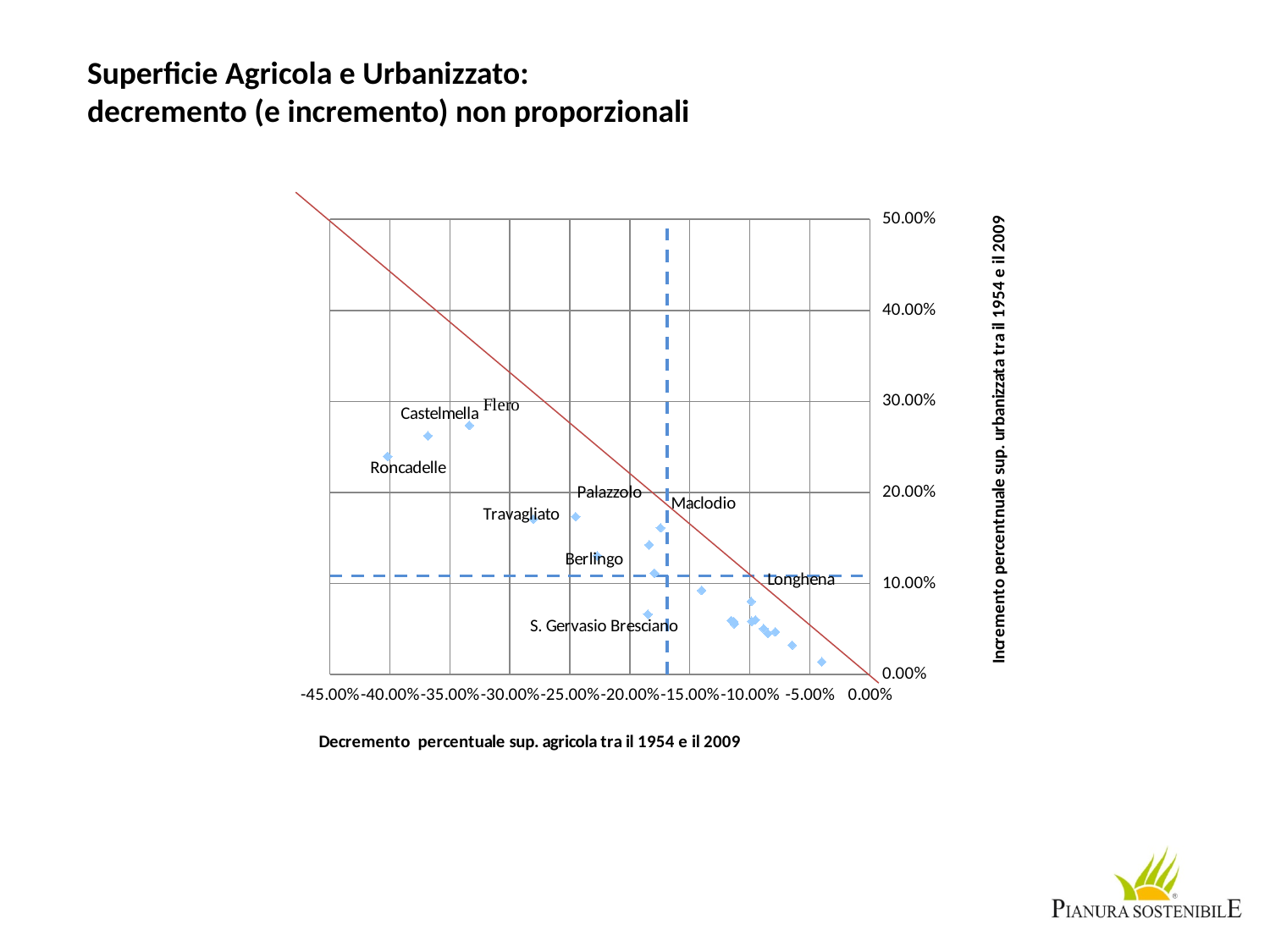
How many points on the chart are labeled with a municipality name? 9 Which has a higher urbanization increase (y value), Flero or Roncadelle? Flero Moving from left to right along the x axis, do the plotted urbanization increase values generally rise or fall? fall Is the urbanization increase (y value) for Berlingo greater or less than 20%? less Is the urbanization increase (y value) for Travagliato greater or less than 10%? greater What is the highest value shown on the y axis of the chart? 50.00% Which has a higher urbanization increase (y value), Travagliato or Berlingo? Travagliato Is the urbanization increase (y value) for Roncadelle greater or less than 20%? greater What is the title of the x axis of the chart? Decremento percentuale sup. agricola tra il 1954 e il 2009 What kind of chart is shown on the slide? scatter chart